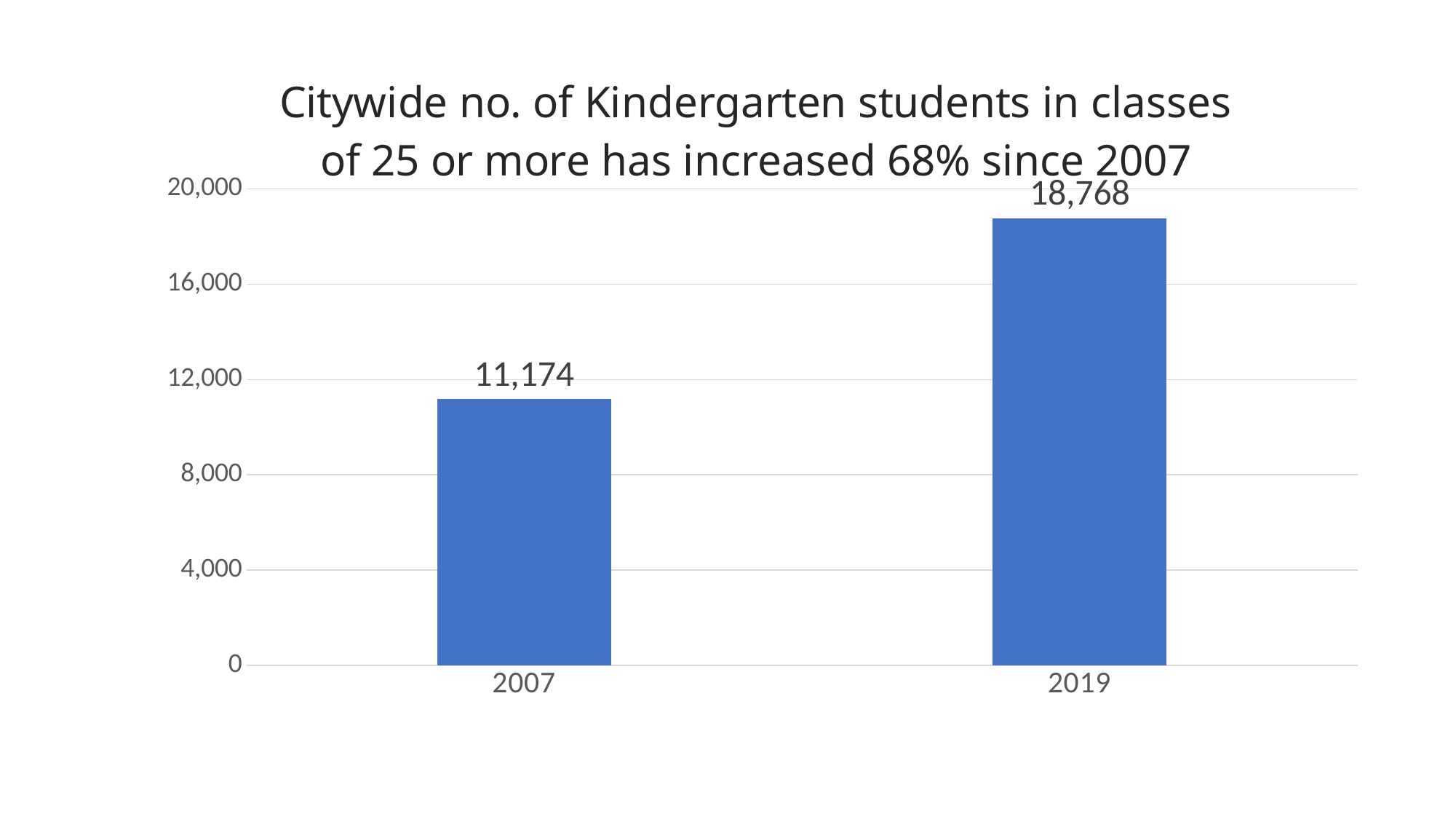
What kind of chart is this? bar chart What is the value for 2007? 11,174 Is the value for 2007 larger or smaller than the value for 2019? smaller What is the title of the chart? Citywide no. of Kindergarten students in classes of 25 or more has increased 68% since 2007 Do the values rise or fall from 2007 to 2019? rise What is the difference between the values for 2019 and 2007? 7,594 What is the value for 2019? 18,768 Which year has the higher value? 2019 Is the value for 2019 greater or less than 16,000? greater Is the value for 2007 greater or less than 12,000? less How many categories are shown on the x axis? 2 Which year has the lower value? 2007